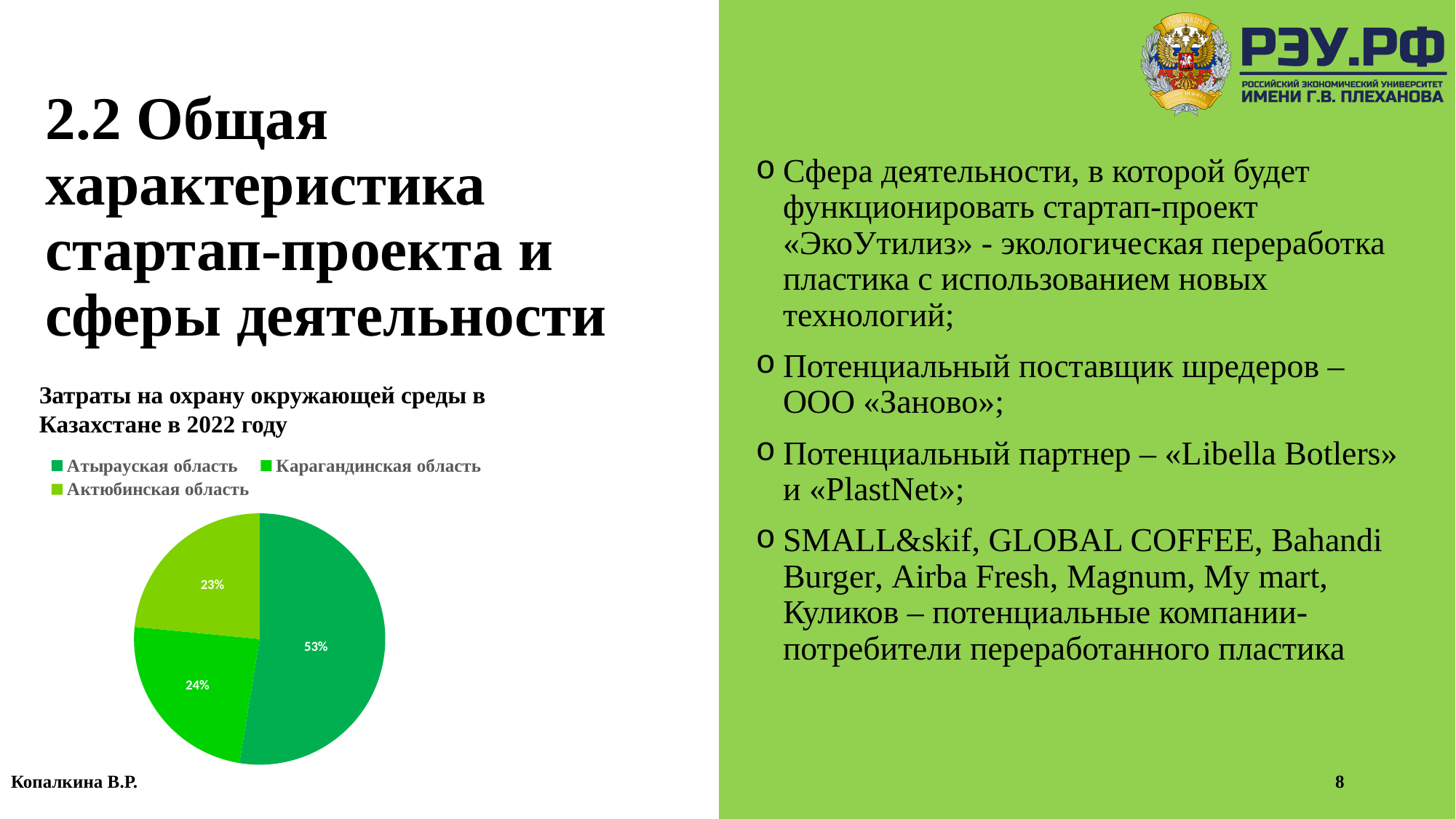
Which region has the smallest slice of the pie? Актюбинская область Which region has the largest slice of the pie? Атырауская область What type of chart is shown on the slide? pie chart What is the title of the chart on the slide? Затраты на охрану окружающей среды в Казахстане в 2022 году How many entries does the chart legend list? 3 What share of the pie does Актюбинская область have? 23% What share of the pie does Карагандинская область have? 24% Which is larger, the share of Карагандинская область or the share of Актюбинская область? Карагандинская область Is the share of Атырауская область greater or less than 50%? greater How many slices does the pie chart have? 3 What share of the pie does Атырауская область have? 53% What is the difference in percentage points between Атырауская область and Карагандинская область? 29